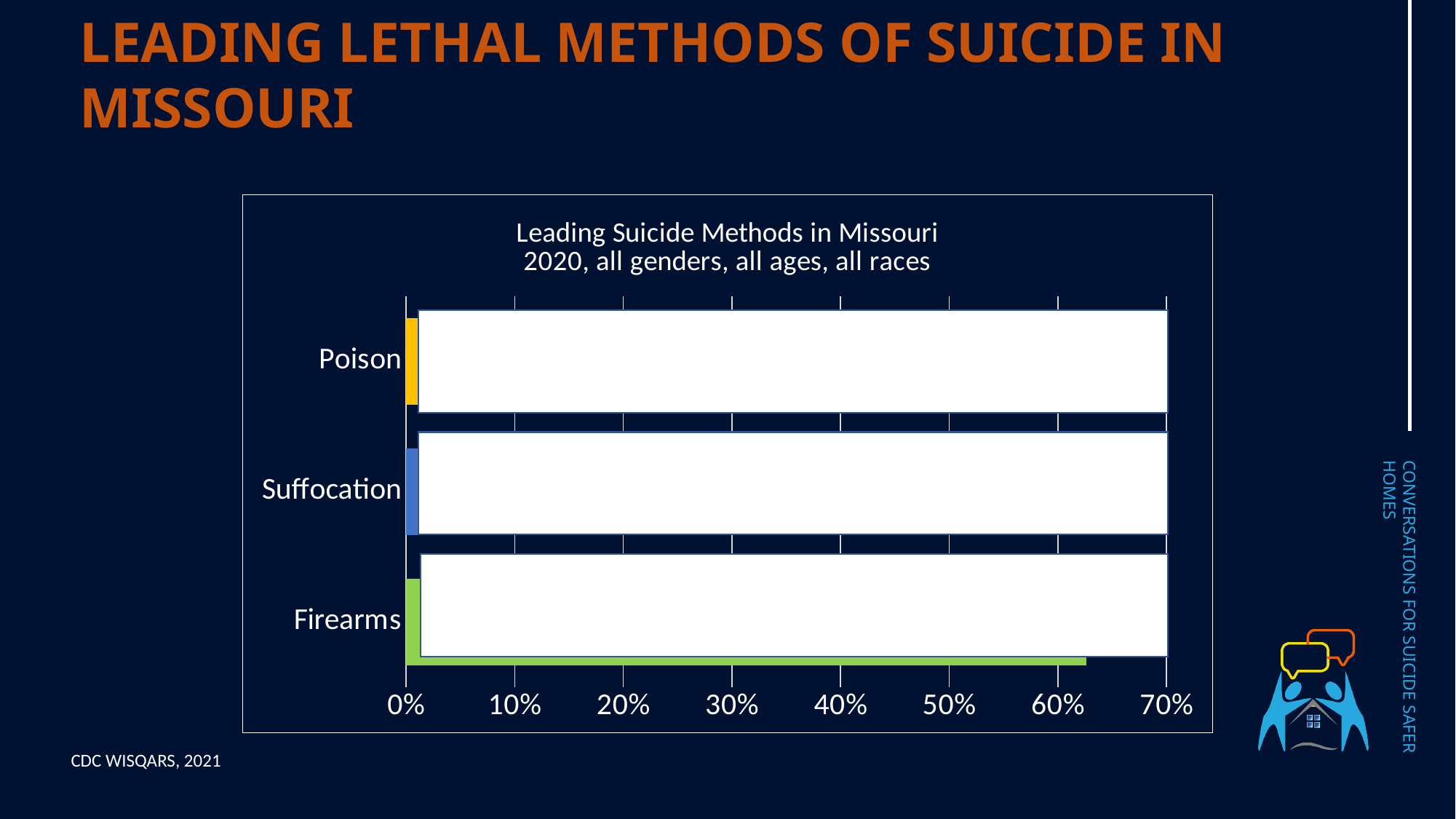
How many suicide methods (categories) are listed on the chart? 3 What kind of chart is shown on the slide? bar chart Is the value for Firearms greater or less than 70%? less Is the value for Firearms greater or less than 50%? greater Which category is listed at the top of the chart? Poison What colour is the bar for Firearms? green What is the highest value shown on the x axis? 70% What is the title of the chart? Leading Suicide Methods in Missouri 2020, all genders, all ages, all races Is the value for Firearms greater or less than 60%? greater